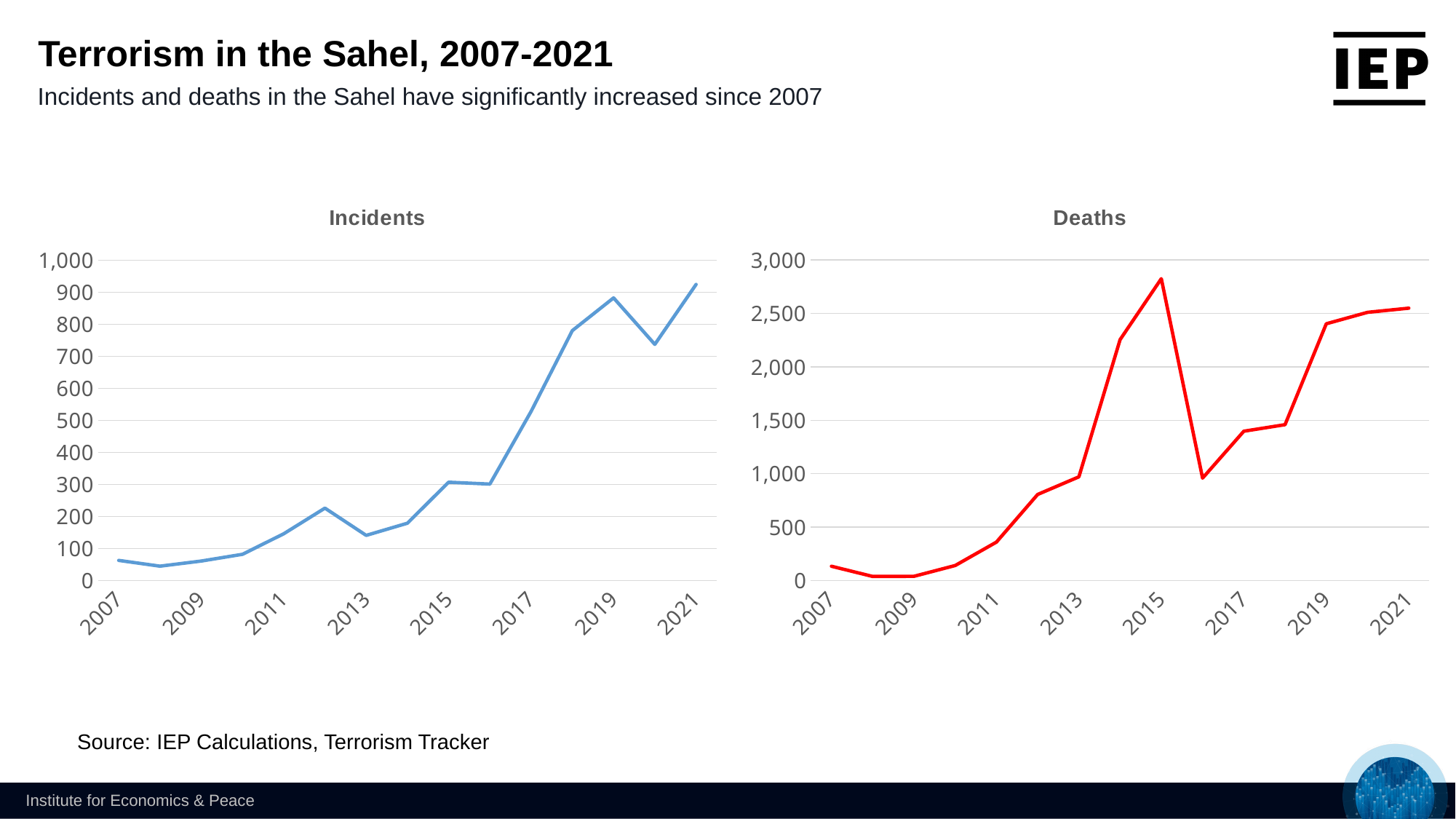
In the Deaths chart, do the values generally rise or fall from 2007 to 2015? rise In the Incidents chart, which year has a higher value, 2019 or 2020? 2019 In the Deaths chart, which year has the highest number of deaths? 2015 In the Incidents chart, which year has the highest number of incidents? 2021 What colour is the line in the Deaths chart? red In the Incidents chart, is the value for 2019 greater or less than 800? greater In the Incidents chart, is the value for 2013 greater or less than 200? less What is the title of the chart on the right? Deaths What kind of chart is the Incidents chart? line chart In the Deaths chart, is the value for 2014 greater or less than 2,000? greater In the Deaths chart, which year has a higher value, 2015 or 2021? 2015